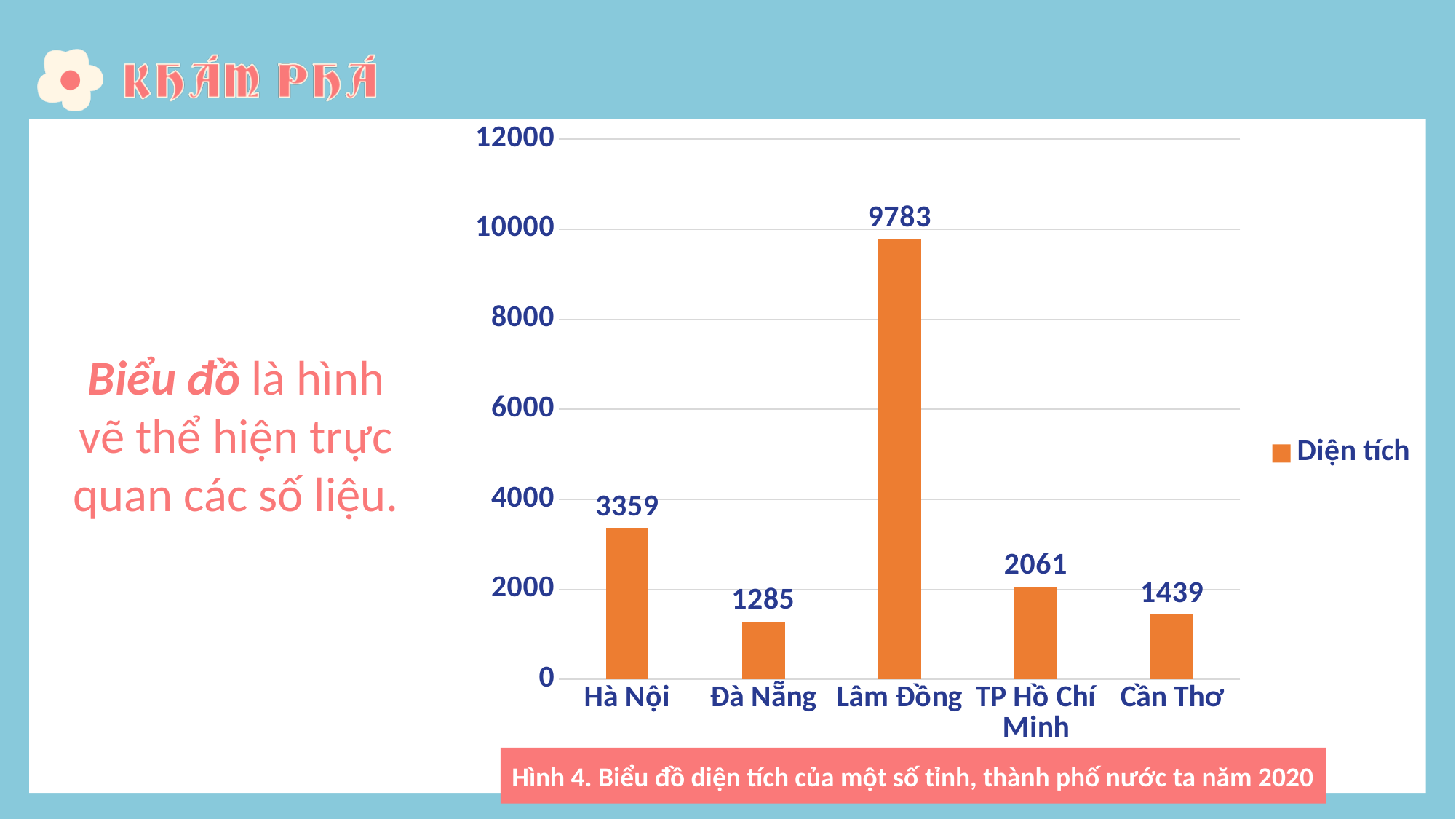
What kind of chart is shown? bar chart What is the name of the series shown in the legend? Diện tích Which category has the lowest value? Đà Nẵng Is the value for TP Hồ Chí Minh greater or less than 4000? less How many categories are shown on the x axis? 5 Which category has the highest value? Lâm Đồng What is the difference between the values for Hà Nội and TP Hồ Chí Minh? 1298 What is the value for Cần Thơ? 1439 What is the value for Hà Nội? 3359 Which is larger, the value for Đà Nẵng or the value for Cần Thơ? Cần Thơ How many series does the legend list? 1 What is the value for Lâm Đồng? 9783